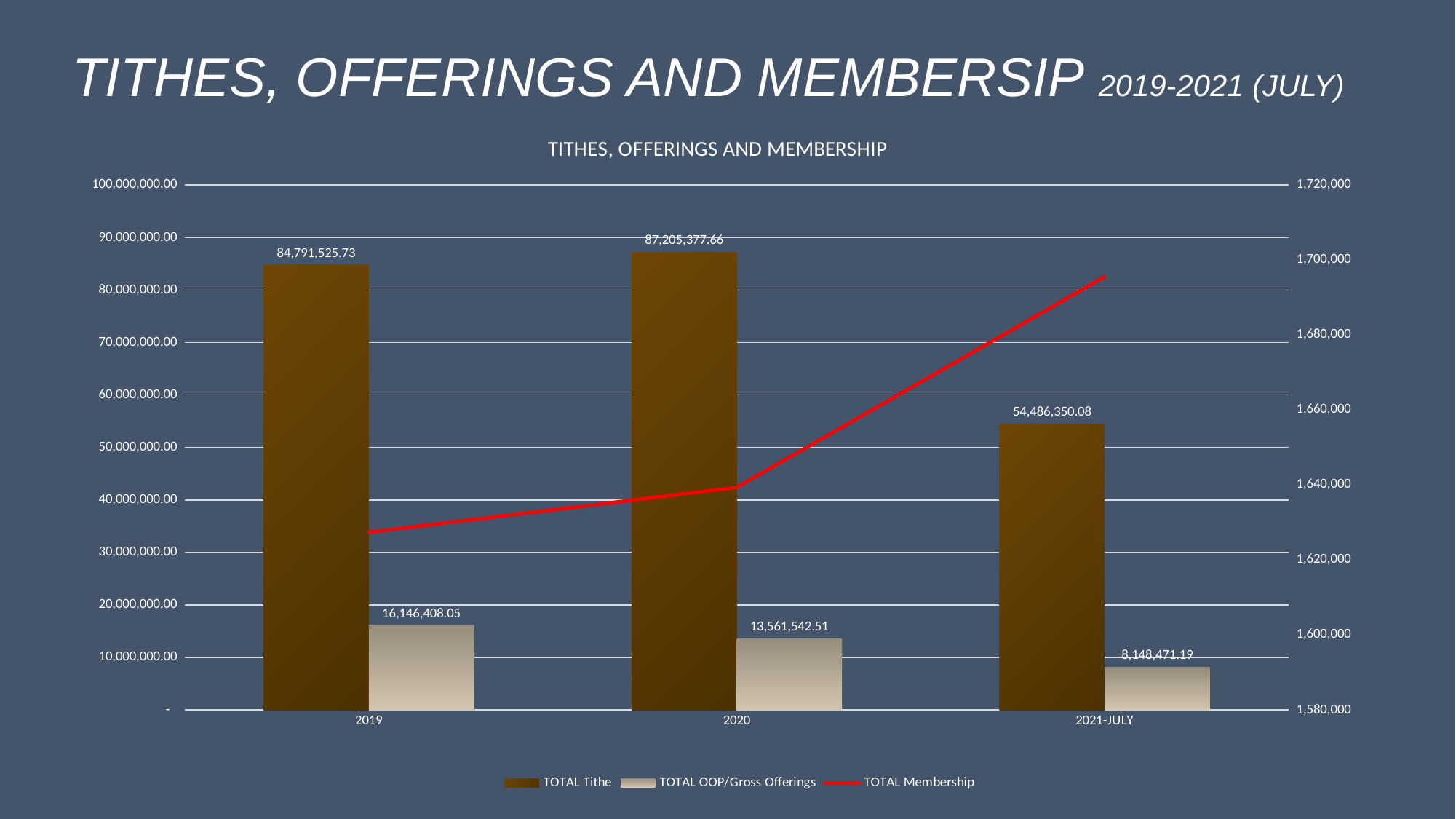
What colour is the TOTAL Membership line? Red What is the difference between the TOTAL Tithe for 2020 and 2019? 2,413,851.93 Does the TOTAL Membership line rise or fall from 2019 to 2021-JULY? rises What is the TOTAL Tithe value for 2021-JULY? 54,486,350.08 What is the TOTAL Tithe value for 2020? 87,205,377.66 How many series does the legend list? 3 Is the TOTAL Membership value for 2019 greater or less than 1,640,000? less Which category has the lowest TOTAL OOP/Gross Offerings? 2021-JULY Which is larger, the TOTAL OOP/Gross Offerings for 2019 or for 2020? 2019 What is the TOTAL OOP/Gross Offerings value for 2019? 16,146,408.05 Is the TOTAL Membership value for 2021-JULY greater or less than 1,680,000? greater Which year has the highest TOTAL Tithe? 2020